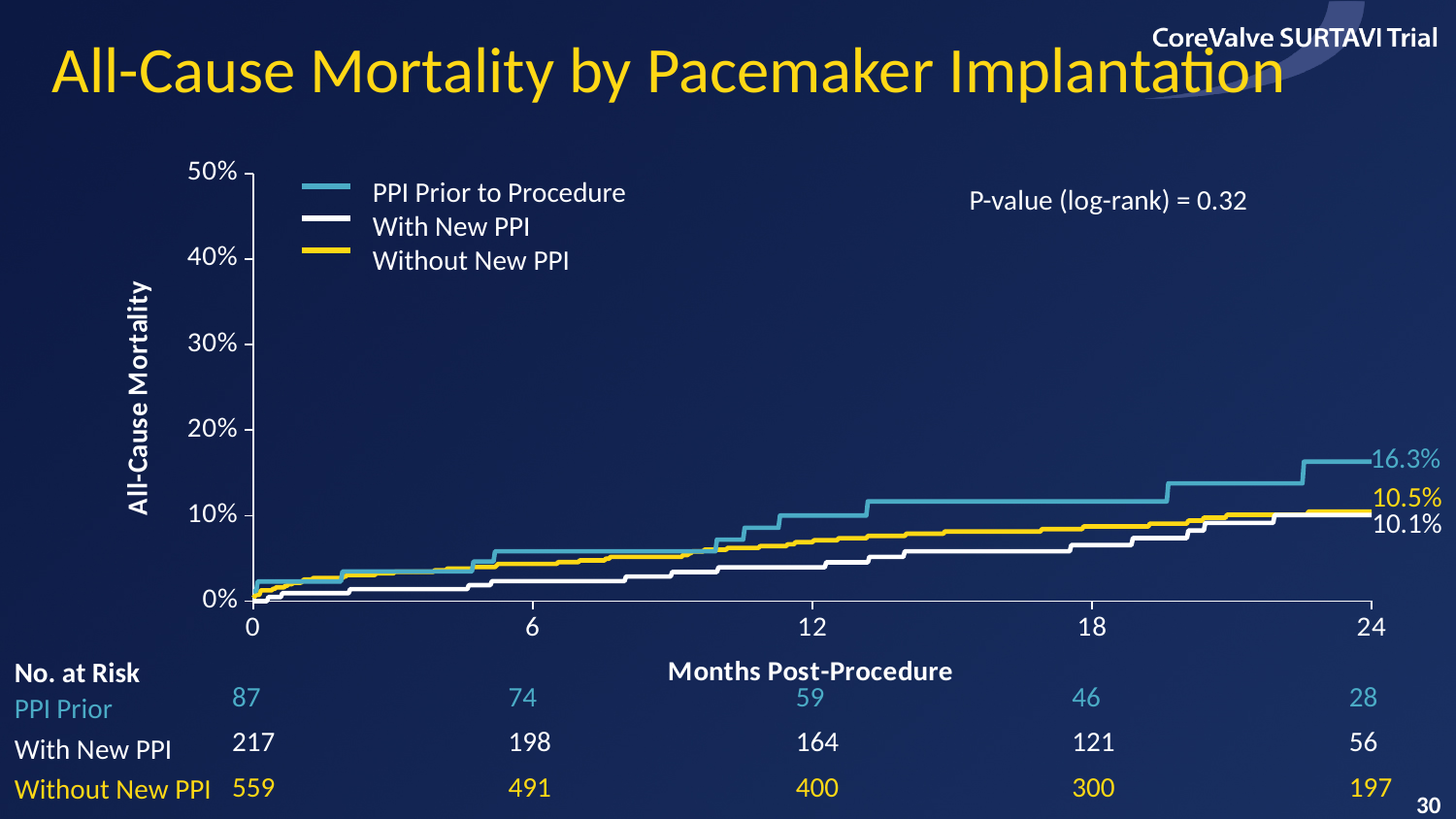
What is the all-cause mortality at 24 months for the Without New PPI group? 10.5% Is the 24-month all-cause mortality for the PPI Prior to Procedure group greater or less than 20%? less What is the all-cause mortality at 24 months for the PPI Prior to Procedure group? 16.3% What is the P-value (log-rank) shown on the chart? 0.32 Which group has the highest all-cause mortality at 24 months? PPI Prior to Procedure What kind of chart is shown on the slide? Line chart (Kaplan-Meier curve) Which group has the lowest all-cause mortality at 24 months? With New PPI How many series does the legend list? 3 What is the difference in 24-month all-cause mortality between the PPI Prior to Procedure group and the With New PPI group? 6.2% Do the all-cause mortality curves rise or fall as months post-procedure increase? rise How many patients in the Without New PPI group were at risk at 12 months? 400 What is the all-cause mortality at 24 months for the With New PPI group? 10.1%